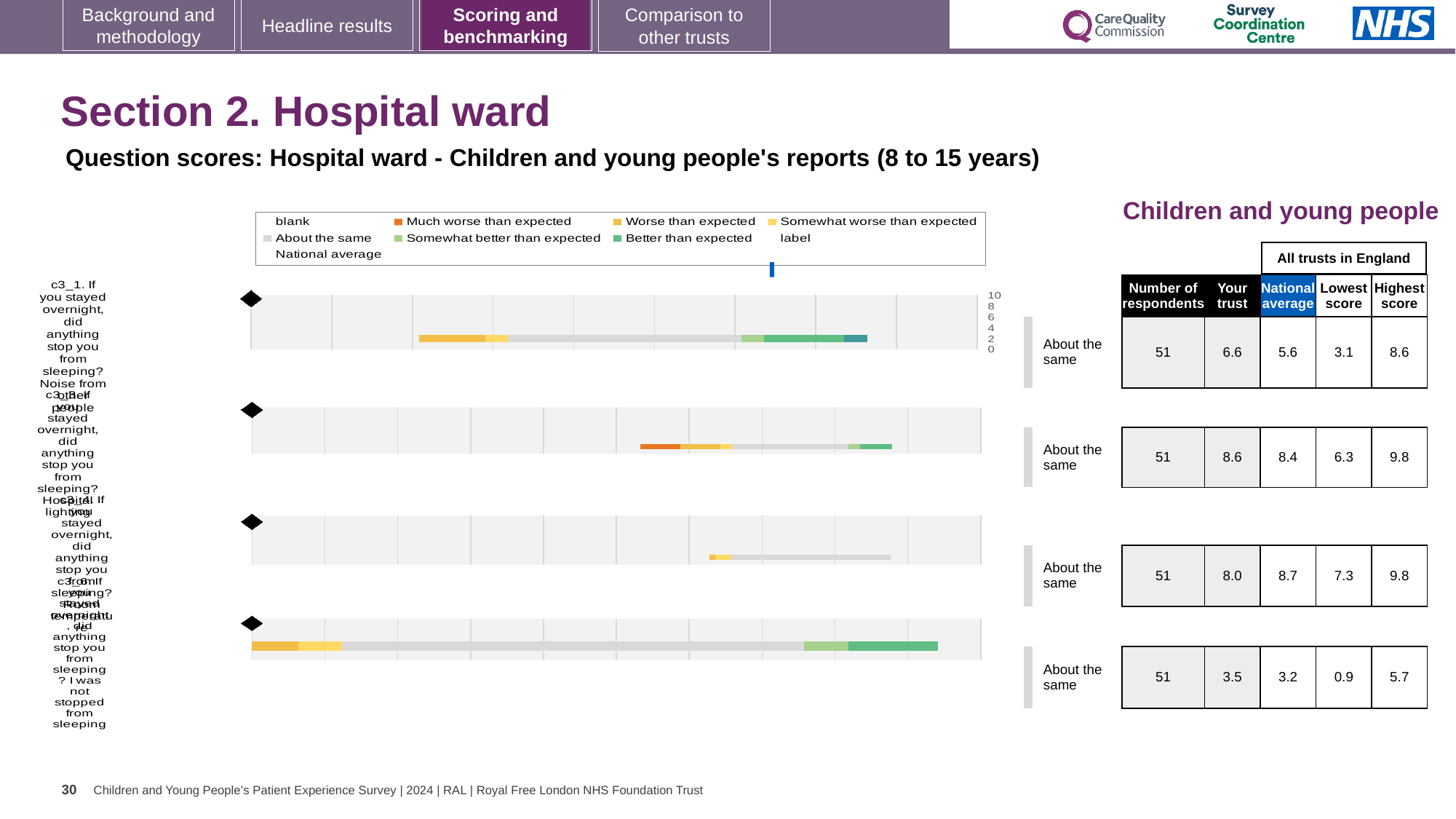
For the third question row, which is larger: the 'Your trust' score or the national average? national average What kind of chart is used to show the question scores on this slide? bar chart In the table next to the charts, what is the 'Your trust' score for the first (top) question row? 6.6 What colour does the legend use for 'Much worse than expected'? orange Which question row has the highest 'Your trust' score in the table? the second row (8.6) Which question row has the lowest 'Your trust' score in the table? the fourth row (3.5) How many question rows (bars) are plotted on the slide? 4 How many respondents are listed for the first question row? 51 What is the highest score across all trusts in England for the fourth question row? 5.7 In the table next to the charts, what is the national average for the second question row? 8.4 For the first question row, what is the difference between the highest score and the lowest score across all trusts in England? 5.5 What benchmark category is shown beside each of the four question rows? About the same